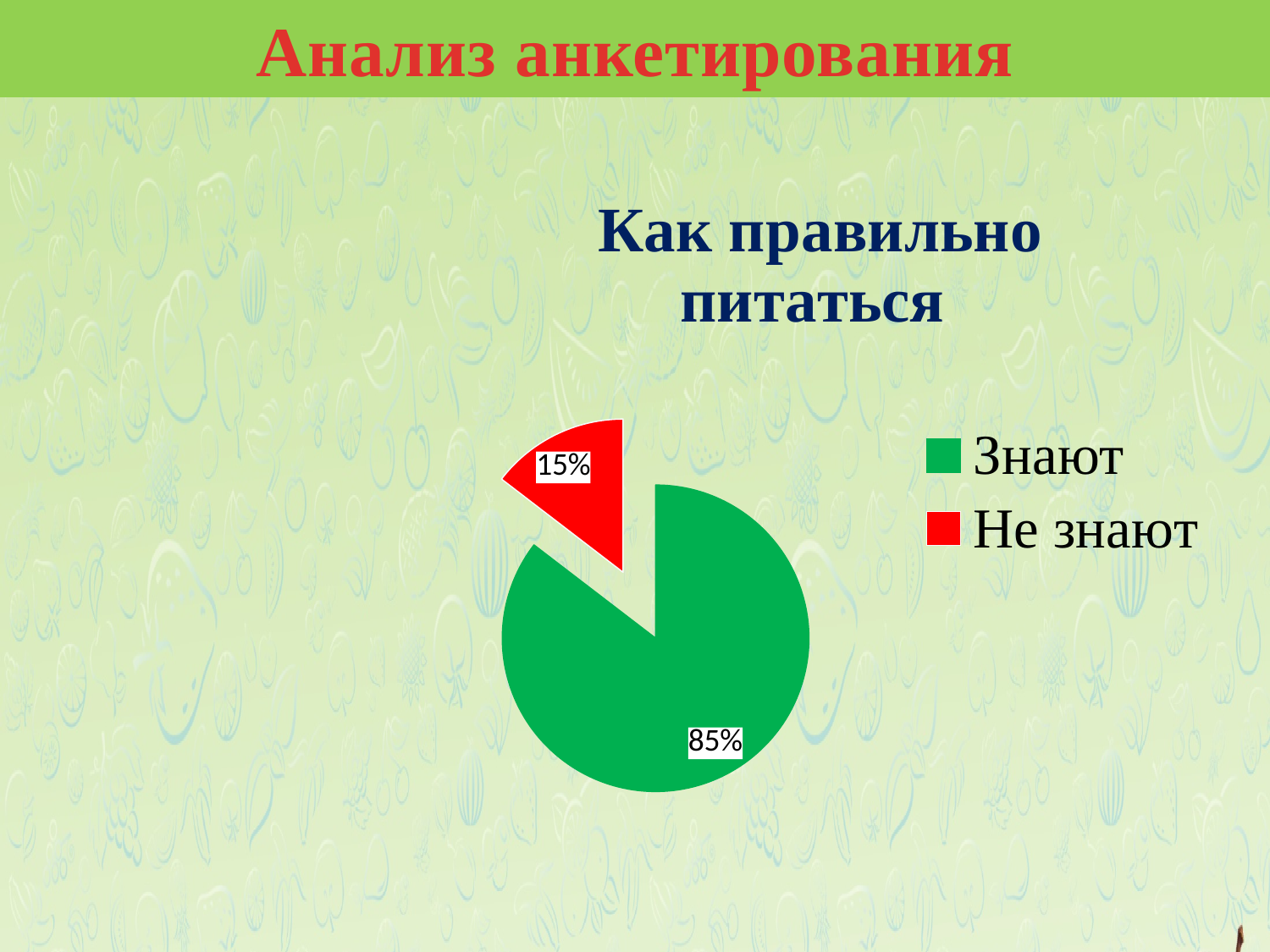
What percentage of the pie is labelled "Знают"? 85% Which is larger: the "Знают" slice or the "Не знают" slice? Знают How many slices does the pie chart have? 2 What percentage of the pie is labelled "Не знают"? 15% What share of the pie does the "Знают" slice take? 85% What is the title of the chart? Как правильно питаться What is the difference in percentage points between the "Знают" and "Не знают" slices? 70 Which slice of the pie is the largest? Знают What colour is the "Не знают" slice? red What kind of chart is shown on the slide? pie chart Which slice of the pie is the smallest? Не знают How many entries does the legend list? 2